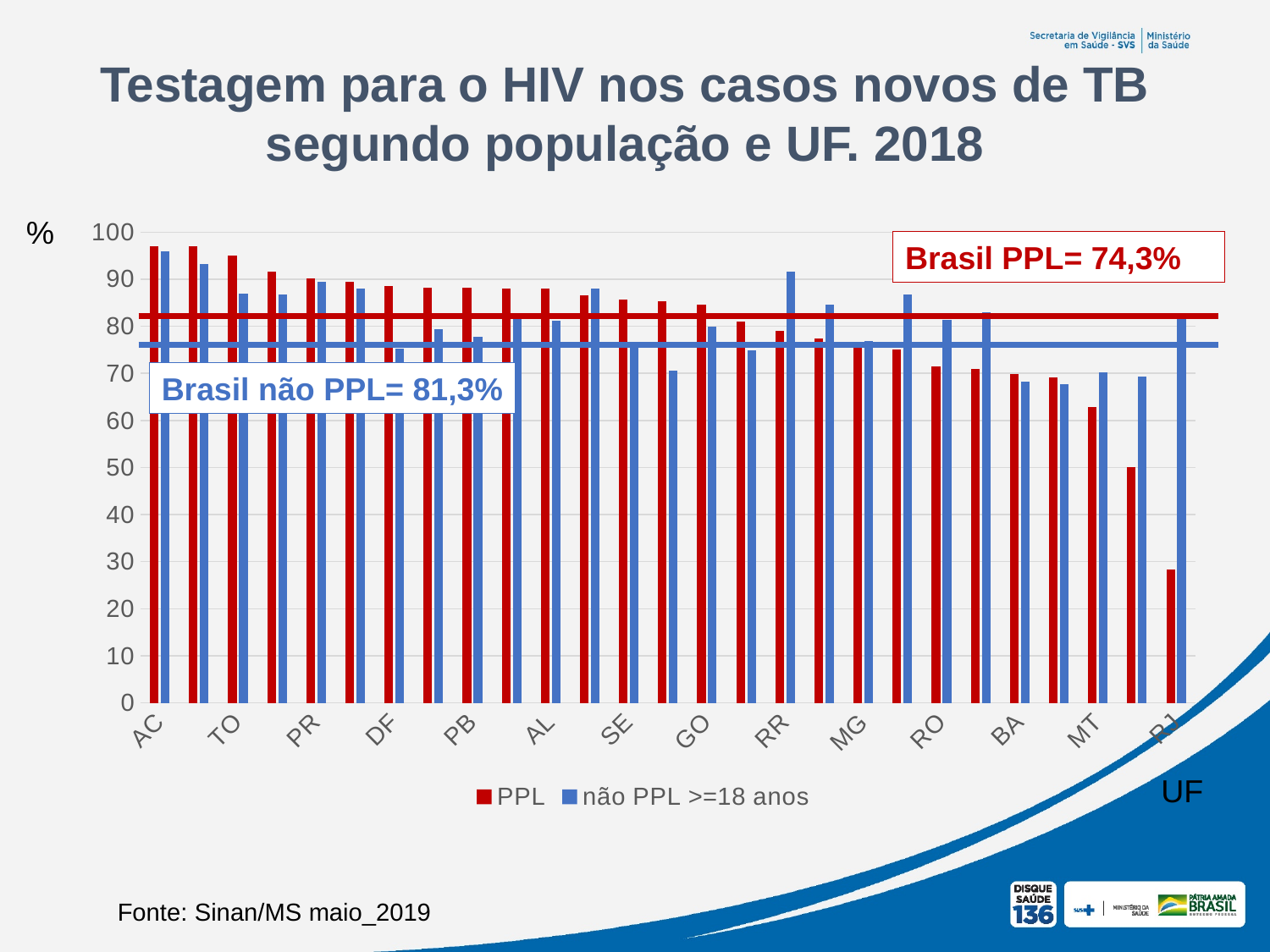
Do the PPL values rise or fall from left to right along the x axis? fall What is the value shown for Brasil não PPL in the annotation box? 81,3% Which UF has the lowest PPL value? RJ What is the value shown for Brasil PPL in the annotation box? 74,3% How many series does the legend list? 2 What kind of chart is shown on the slide? bar chart Is the PPL value for AC greater or less than 90? greater For RR, which series has the larger value, PPL or não PPL >=18 anos? não PPL >=18 anos Is the não PPL >=18 anos value for RR greater or less than 90? greater Is the PPL value for RJ greater or less than 30? less What is the difference between the Brasil não PPL value (81,3%) and the Brasil PPL value (74,3%)? 7 percentage points For GO, which series has the larger value, PPL or não PPL >=18 anos? PPL